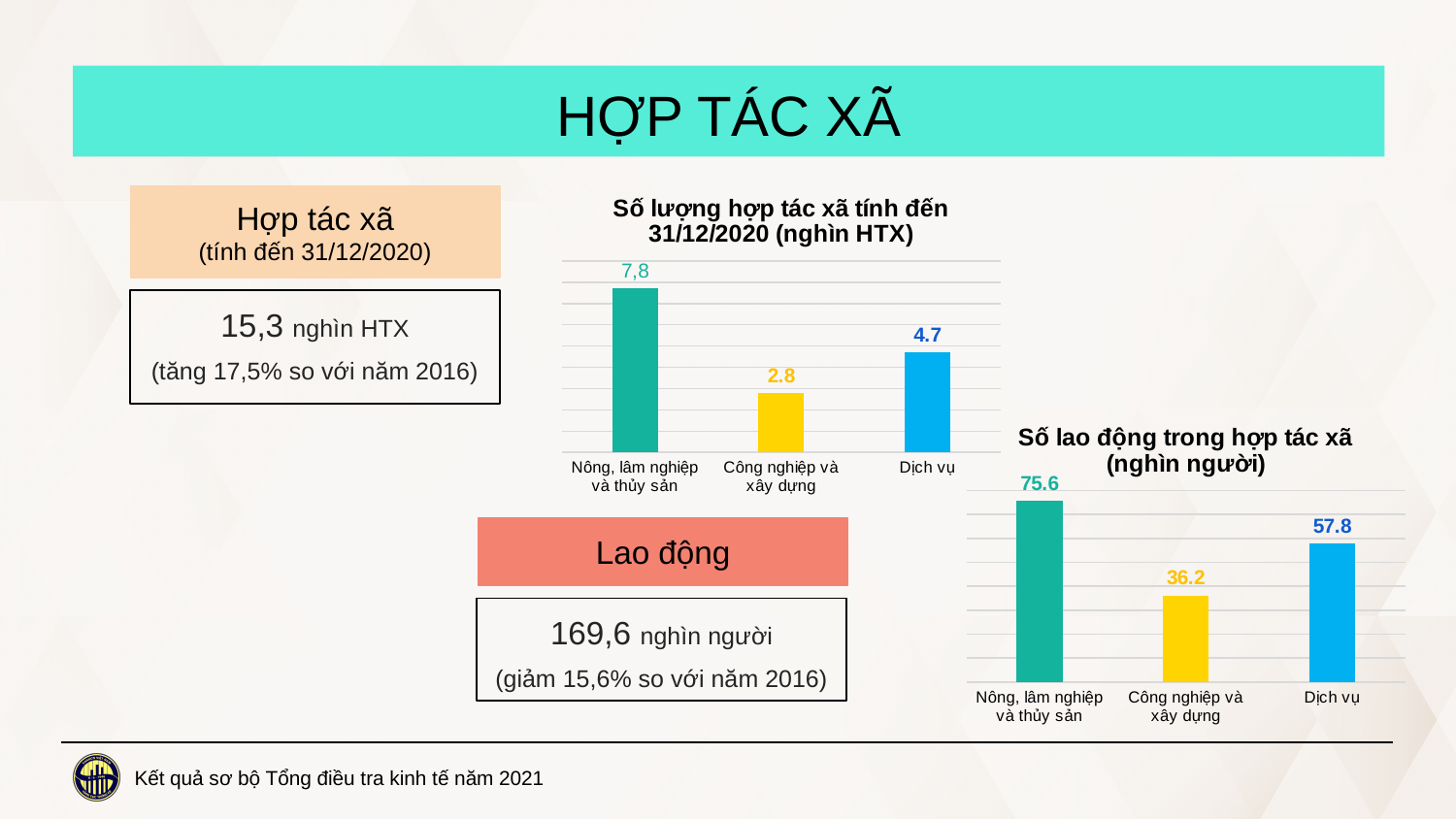
In the chart 'Số lao động trong hợp tác xã (nghìn người)', which is larger, Dịch vụ or Công nghiệp và xây dựng? Dịch vụ In the chart 'Số lượng hợp tác xã tính đến 31/12/2020 (nghìn HTX)', what is the value for Công nghiệp và xây dựng? 2.8 In the chart 'Số lao động trong hợp tác xã (nghìn người)', what is the difference between Nông, lâm nghiệp và thủy sản and Công nghiệp và xây dựng? 39.4 What kind of chart is 'Số lao động trong hợp tác xã (nghìn người)'? Bar chart In the chart 'Số lượng hợp tác xã tính đến 31/12/2020 (nghìn HTX)', what is the value for Nông, lâm nghiệp và thủy sản? 7,8 In the chart 'Số lượng hợp tác xã tính đến 31/12/2020 (nghìn HTX)', how many categories are shown? 3 In the chart 'Số lao động trong hợp tác xã (nghìn người)', what is the value for Dịch vụ? 57.8 In the chart 'Số lượng hợp tác xã tính đến 31/12/2020 (nghìn HTX)', what colour is the bar for Dịch vụ? Blue In the chart 'Số lao động trong hợp tác xã (nghìn người)', what is the value for Nông, lâm nghiệp và thủy sản? 75.6 In the chart 'Số lượng hợp tác xã tính đến 31/12/2020 (nghìn HTX)', which category has the lowest value? Công nghiệp và xây dựng In the chart 'Số lao động trong hợp tác xã (nghìn người)', which category has the lowest value? Công nghiệp và xây dựng In the chart 'Số lượng hợp tác xã tính đến 31/12/2020 (nghìn HTX)', which category has the highest value? Nông, lâm nghiệp và thủy sản